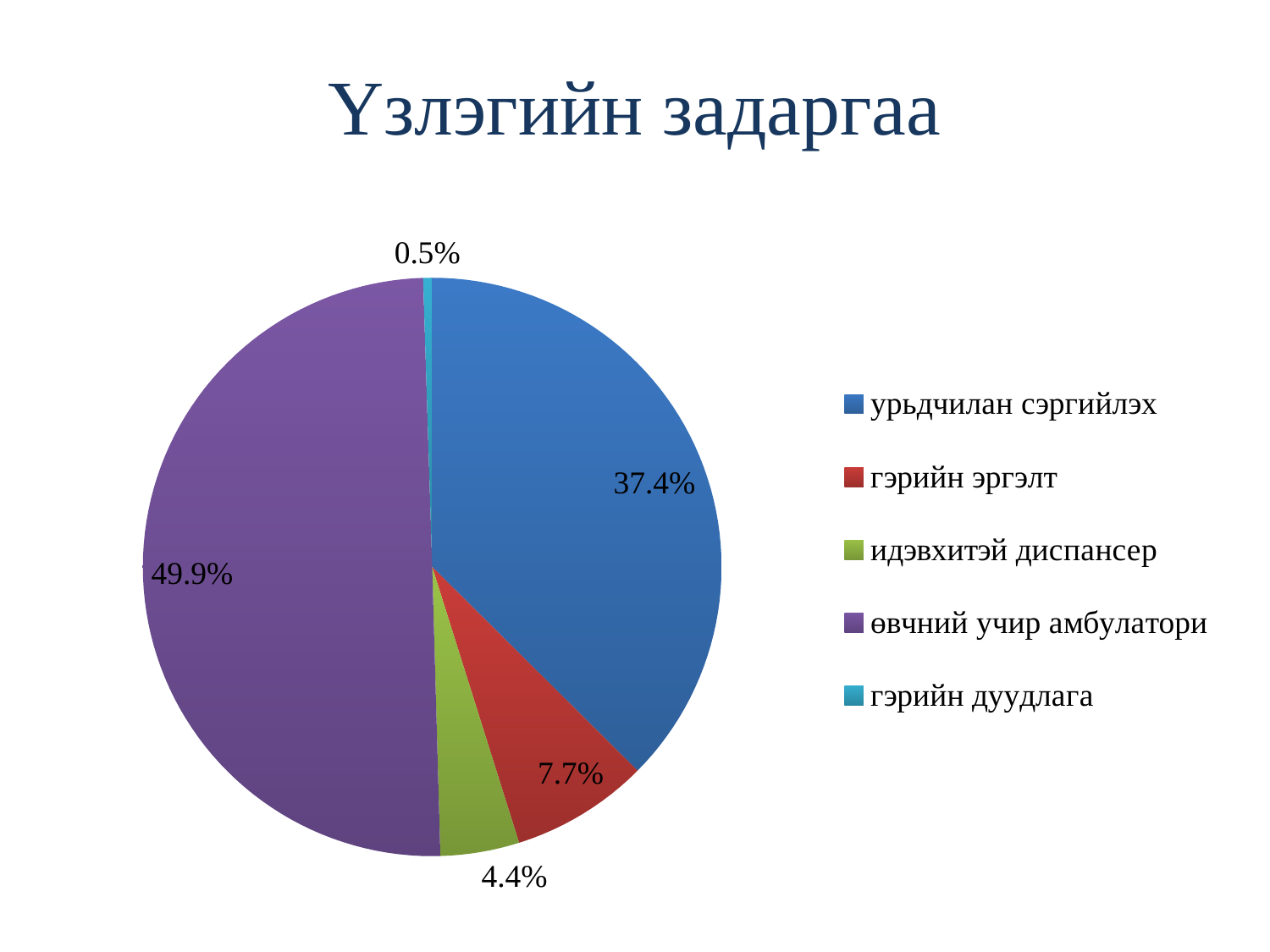
How many categories does the legend list? 5 What is the share for өвчний учир амбулатори? 49.9% What is the share for гэрийн эргэлт? 7.7% What is the share for гэрийн дуудлага? 0.5% What is the share for идэвхитэй диспансер? 4.4% Which category has the largest slice? өвчний учир амбулатори Which category has the smallest slice? гэрийн дуудлага What type of chart is shown on the slide? pie chart What is the title of the chart? Үзлэгийн задаргаа What is the difference between the shares of өвчний учир амбулатори and урьдчилан сэргийлэх? 12.5% Which is larger, the share for гэрийн эргэлт or идэвхитэй диспансер? гэрийн эргэлт What is the share for урьдчилан сэргийлэх? 37.4%